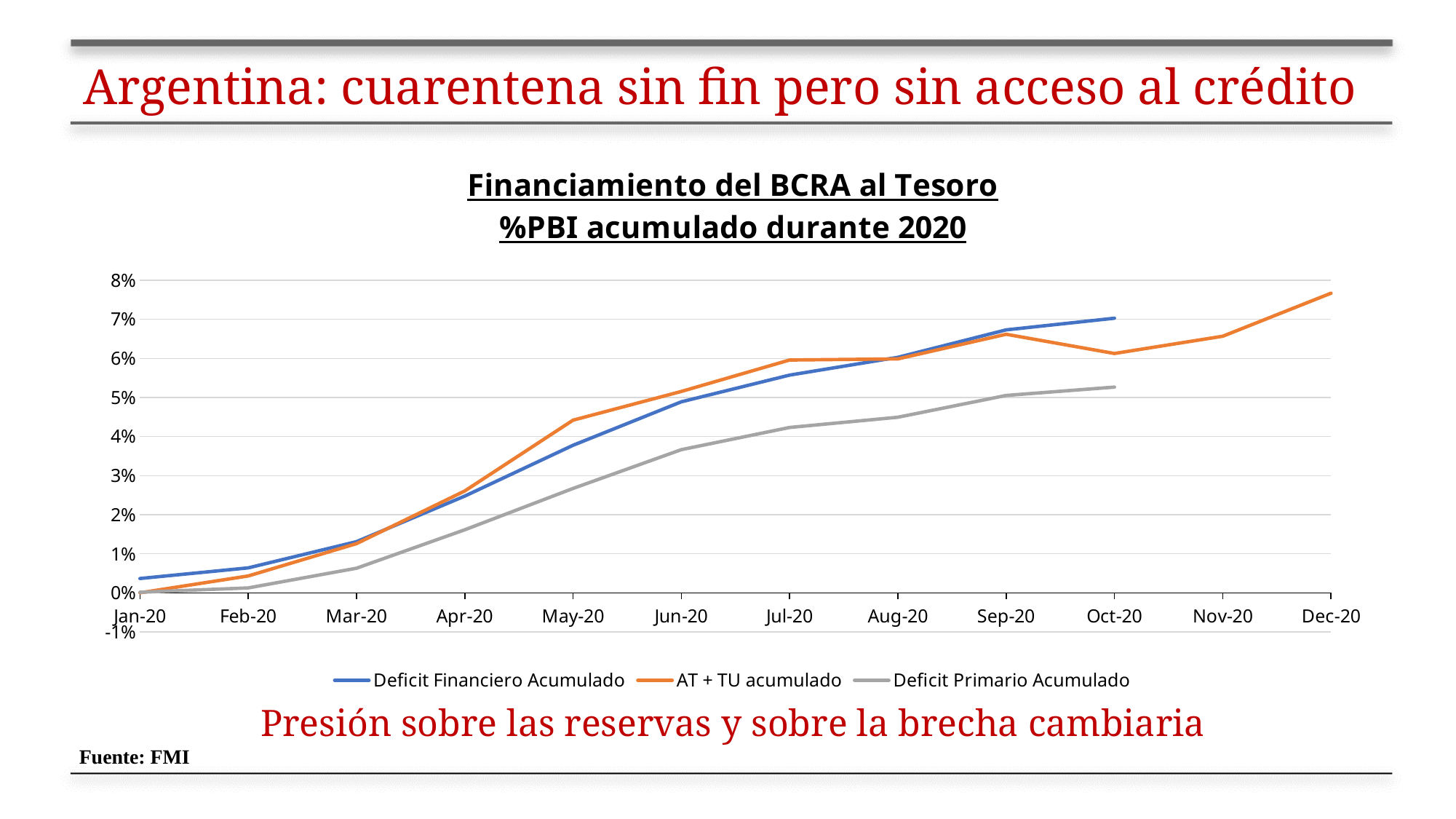
What kind of chart is shown on the slide? line chart Is the value for Deficit Primario Acumulado in Jun-20 greater or less than 4%? less How many months are shown on the x axis? 12 In which month does the AT + TU acumulado series reach its highest value? Dec-20 In Oct-20, which is larger: Deficit Financiero Acumulado or AT + TU acumulado? Deficit Financiero Acumulado In which month is the Deficit Primario Acumulado series at its lowest value? Jan-20 Is the value for Deficit Financiero Acumulado in Jul-20 greater or less than 5%? greater In Jun-20, which is larger: Deficit Primario Acumulado or AT + TU acumulado? AT + TU acumulado How many series does the legend list? 3 Is the value for AT + TU acumulado in Dec-20 greater or less than 7%? greater Does the AT + TU acumulado series generally rise or fall from Jan-20 to Dec-20? rise What is the title of the chart? Financiamiento del BCRA al Tesoro %PBI acumulado durante 2020